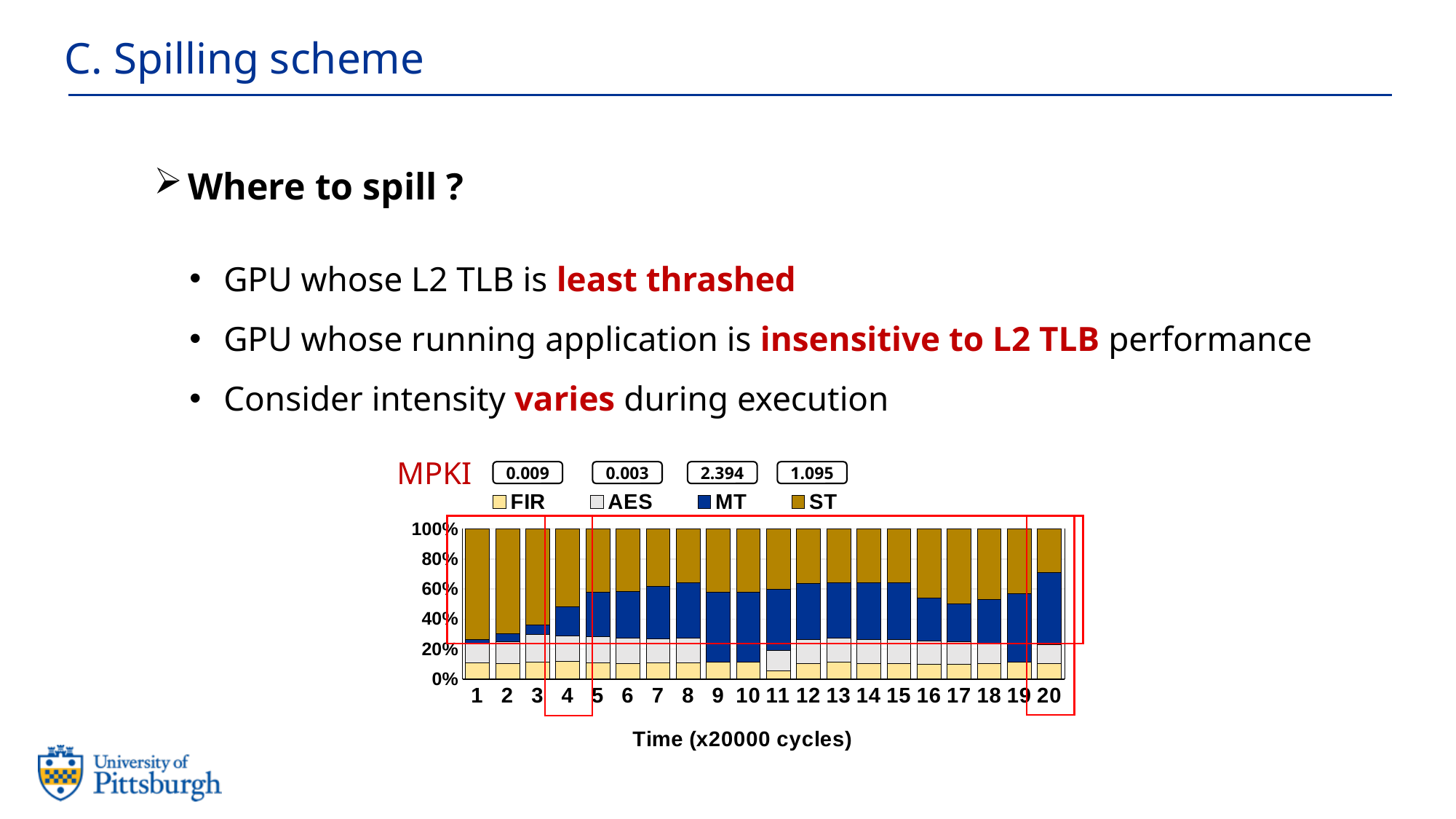
Which application has the lowest MPKI value printed above the chart? AES Does the MT share rise or fall from time 1 to time 4? rise How many series does the chart's legend list? 4 Which series in the legend is drawn in dark blue? MT What is the x-axis title of the chart? Time (x20000 cycles) At time 20, which is larger, the MT share or the ST share? MT What kind of chart is shown on the slide? stacked bar chart Which application has the highest MPKI value printed above the chart? MT What MPKI value is printed above the MT legend entry? 2.394 How many time points are plotted along the x axis of the chart? 20 At time 1, is the ST share of the bar greater or less than 60%? greater At time 1, is the MT share of the bar greater or less than 20%? less